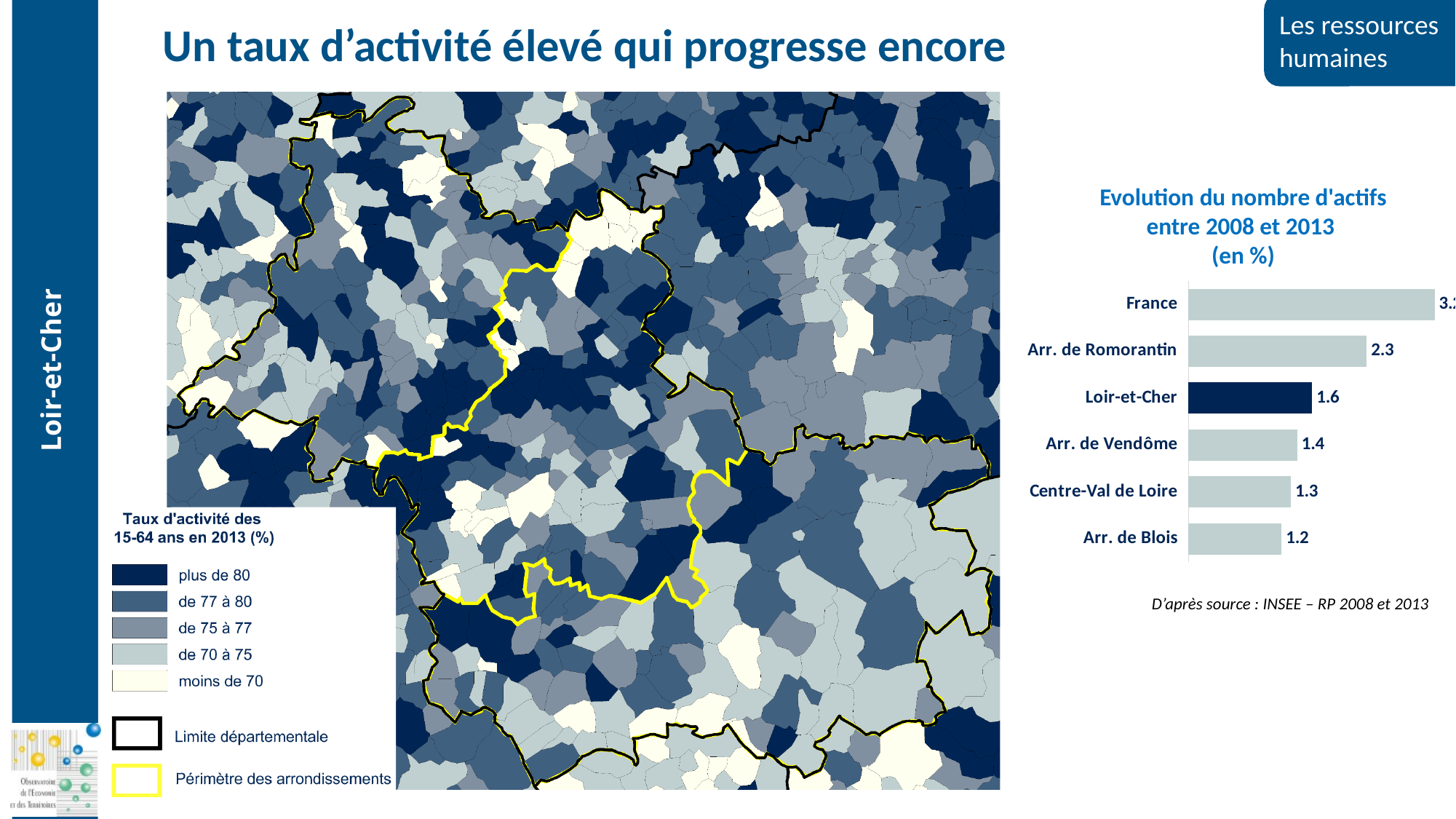
In the chart 'Evolution du nombre d'actifs entre 2008 et 2013 (en %)', what is the value for Centre-Val de Loire? 1.3 In the chart 'Evolution du nombre d'actifs entre 2008 et 2013 (en %)', what is the value for Arr. de Romorantin? 2.3 In the chart 'Evolution du nombre d'actifs entre 2008 et 2013 (en %)', which category has the highest value? France How many categories are shown in the chart 'Evolution du nombre d'actifs entre 2008 et 2013 (en %)'? 6 In the chart 'Evolution du nombre d'actifs entre 2008 et 2013 (en %)', what is the difference between Arr. de Romorantin and Loir-et-Cher? 0.7 In the chart 'Evolution du nombre d'actifs entre 2008 et 2013 (en %)', what is the value for Arr. de Blois? 1.2 In the chart 'Evolution du nombre d'actifs entre 2008 et 2013 (en %)', which bar is highlighted in dark blue? Loir-et-Cher In the chart 'Evolution du nombre d'actifs entre 2008 et 2013 (en %)', what is the value for Arr. de Vendôme? 1.4 In the chart 'Evolution du nombre d'actifs entre 2008 et 2013 (en %)', what is the value for Loir-et-Cher? 1.6 In the chart 'Evolution du nombre d'actifs entre 2008 et 2013 (en %)', which is larger, Loir-et-Cher or Centre-Val de Loire? Loir-et-Cher What kind of chart is 'Evolution du nombre d'actifs entre 2008 et 2013 (en %)'? Bar chart In the chart 'Evolution du nombre d'actifs entre 2008 et 2013 (en %)', which category has the lowest value? Arr. de Blois